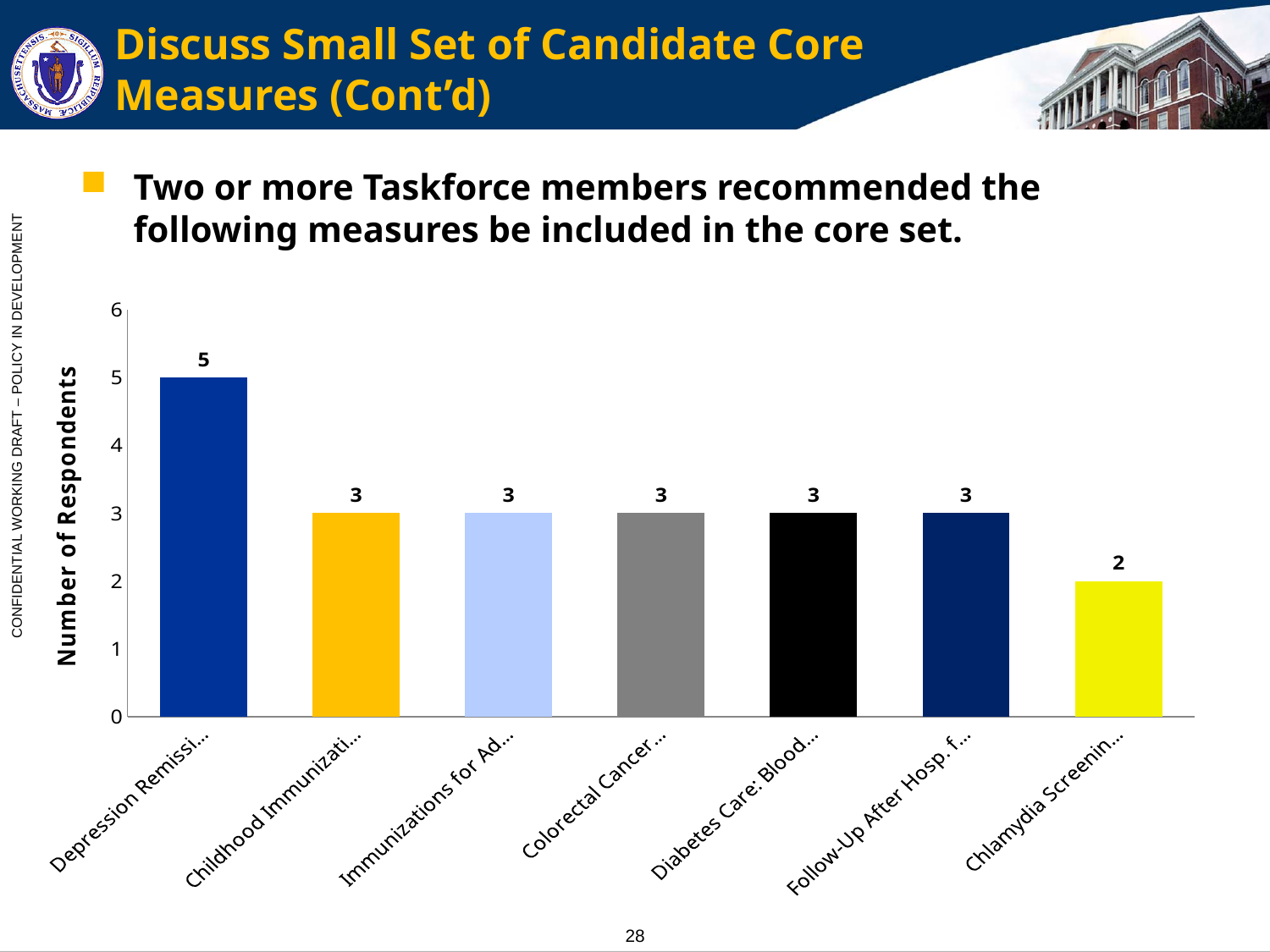
What is the title of the vertical axis of the chart? Number of Respondents Is the number of respondents for the Diabetes Care measure greater or less than 4? less Which has more respondents, the Depression Remission measure or the Follow-Up After Hospitalization measure? Depression Remission What is the number of respondents for the Colorectal Cancer measure? 3 What is the number of respondents for the Chlamydia Screening measure? 2 What is the difference in number of respondents between the Depression Remission measure and the Childhood Immunization measure? 2 What is the difference in number of respondents between the Depression Remission measure and the Chlamydia Screening measure? 3 Which measure has the highest number of respondents? Depression Remission Which measure has the lowest number of respondents? Chlamydia Screening How many measures are shown in the chart? 7 What kind of chart is shown on the slide? bar chart What is the number of respondents for the Depression Remission measure? 5